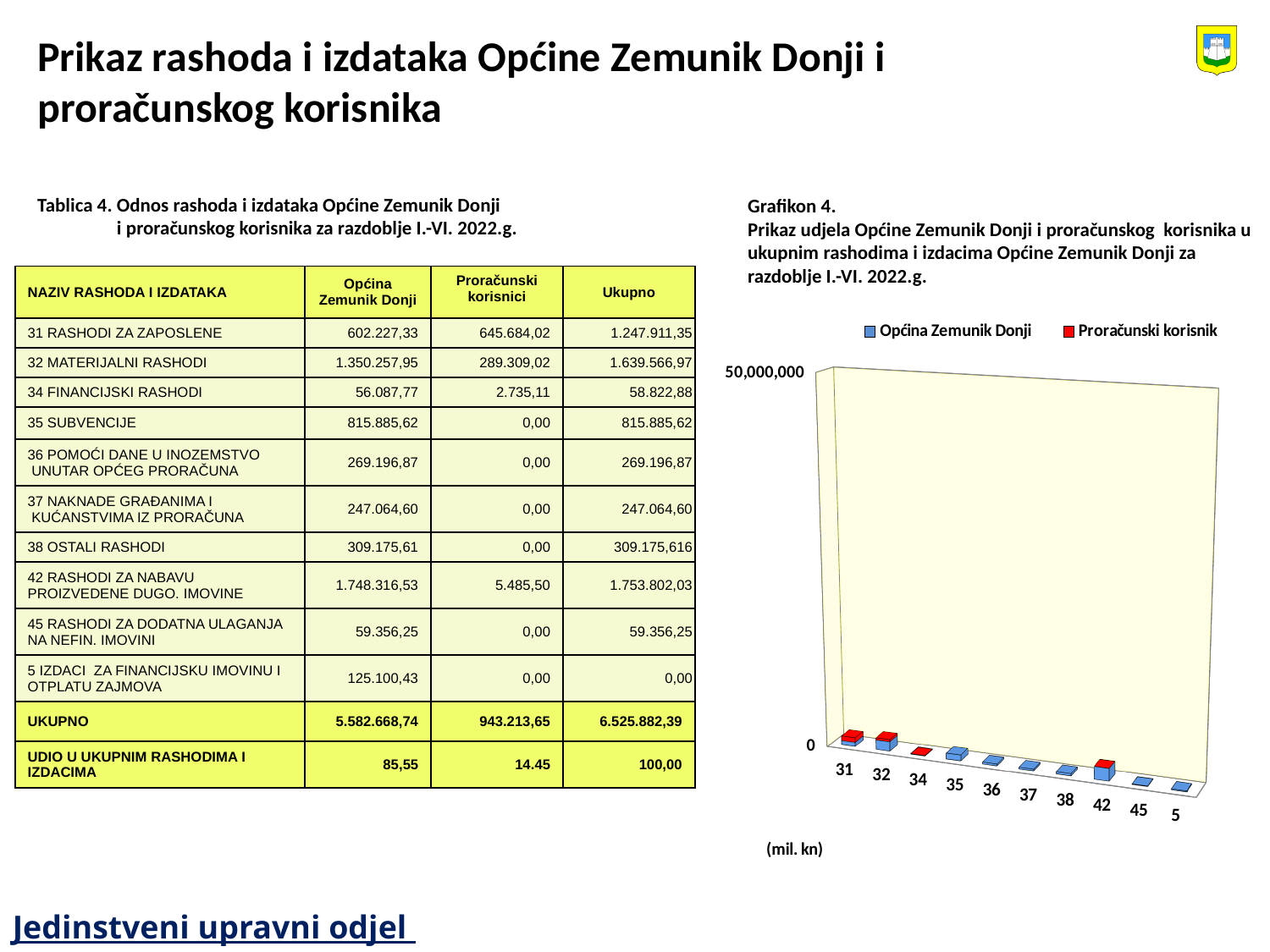
How many series does the legend of Grafikon 4 list? 2 What kind of chart is Grafikon 4? bar chart What is the last category label on the x axis of Grafikon 4? 5 Which series in Grafikon 4 is shown in blue? Općina Zemunik Donji How many categories are shown along the x axis of Grafikon 4? 10 What is the highest value shown on the vertical axis of Grafikon 4? 50,000,000 What is the first category label on the x axis of Grafikon 4? 31 Which series in Grafikon 4 is shown in red? Proračunski korisnik In Grafikon 4, is the value for category 31 greater or less than 50,000,000? less In Grafikon 4, is the value for category 42 greater or less than 50,000,000? less